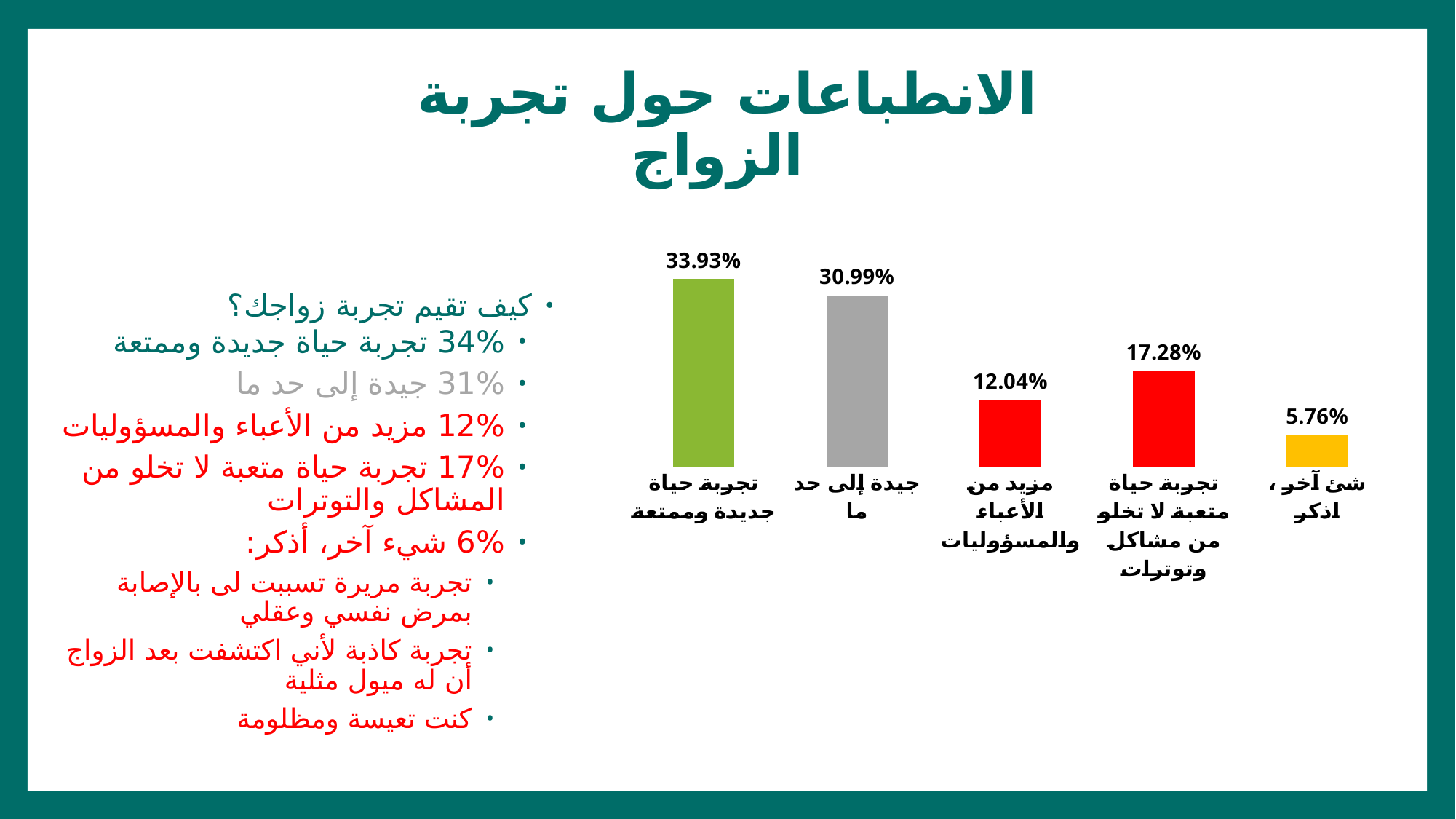
How many categories are plotted in the chart? 5 What value is shown for the category "شئ آخر، اذكر"? 5.76% What colour is the bar for "جيدة إلى حد ما"? Gray Which category has the highest value in the chart? تجربة حياة جديدة وممتعة What is the difference between the values for "تجربة حياة جديدة وممتعة" and "جيدة إلى حد ما"? 2.94% What value is shown for the category "مزيد من الأعباء والمسؤوليات"? 12.04% Which category has the lowest value in the chart? شئ آخر، اذكر What value is shown for the category "تجربة حياة جديدة وممتعة"? 33.93% Which is larger: the value for "مزيد من الأعباء والمسؤوليات" or the value for "تجربة حياة متعبة لا تخلو من مشاكل وتوترات"? تجربة حياة متعبة لا تخلو من مشاكل وتوترات What kind of chart is shown on the slide? Bar chart What value is shown for the category "تجربة حياة متعبة لا تخلو من مشاكل وتوترات"? 17.28% What value is shown for the category "جيدة إلى حد ما"? 30.99%